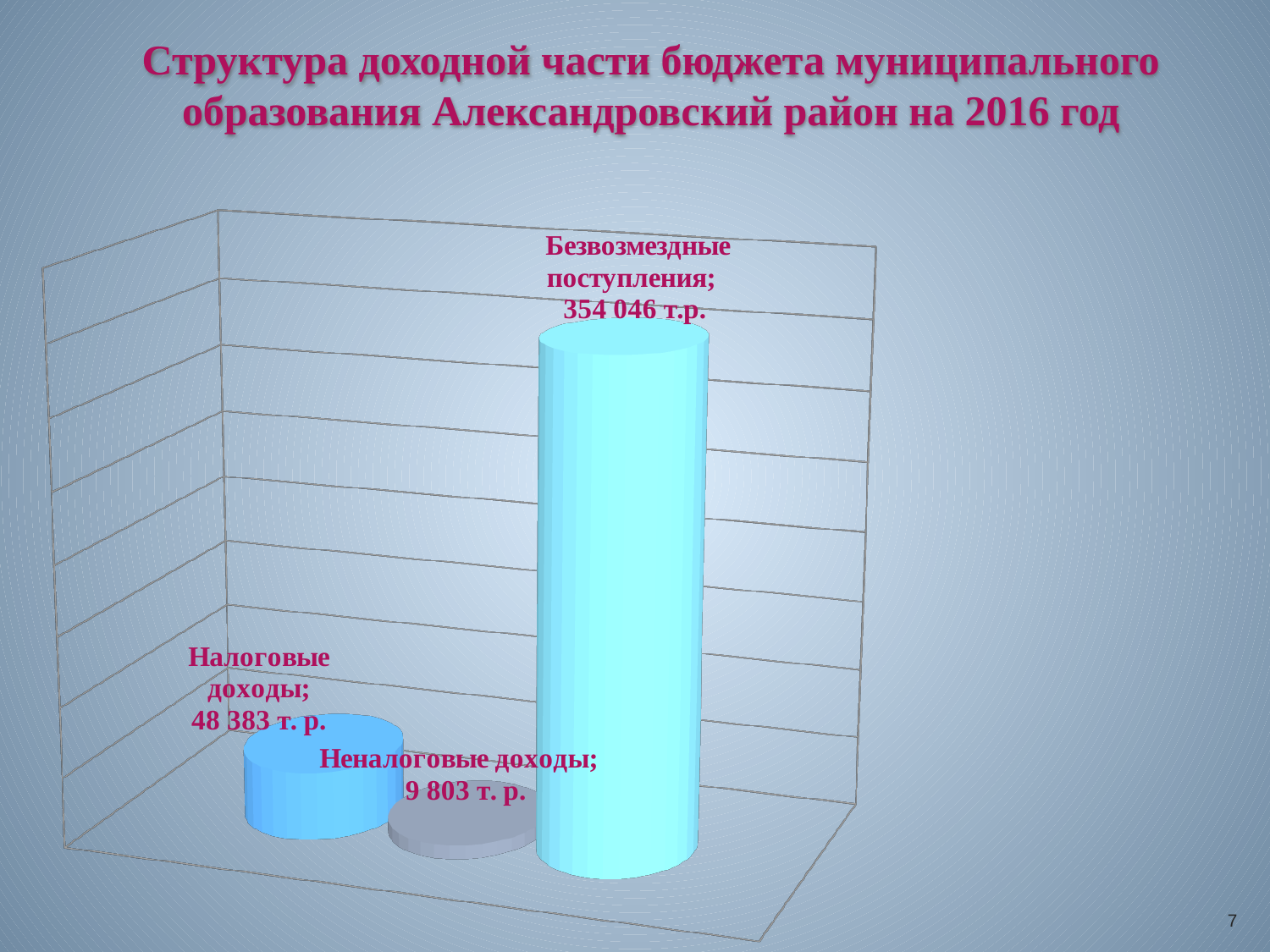
How many categories are shown in the chart? 3 Which is larger, Налоговые доходы or Неналоговые доходы? Налоговые доходы What kind of chart is shown on the slide? Bar chart Which category has the highest value? Безвозмездные поступления What is the difference between Безвозмездные поступления and Налоговые доходы? 305 663 т. р. What is the total of the three categories shown? 412 232 т. р. What year does the slide title say the budget structure is for? 2016 What is the value for Безвозмездные поступления? 354 046 т.р. What is the difference between Налоговые доходы and Неналоговые доходы? 38 580 т. р. What is the value for Неналоговые доходы? 9 803 т. р. What is the value for Налоговые доходы? 48 383 т. р. Which category has the lowest value? Неналоговые доходы